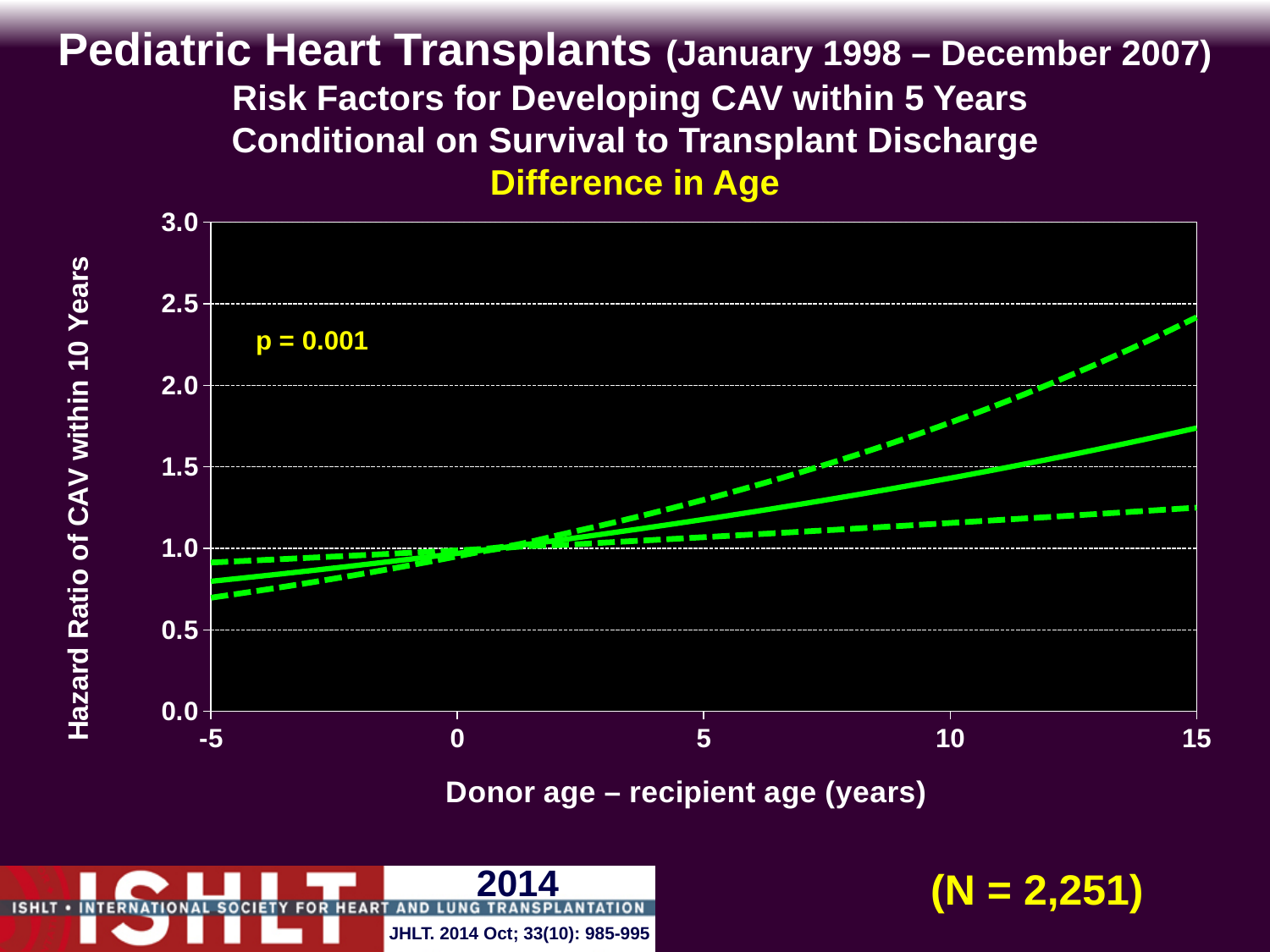
How many lines are plotted on the chart? 3 Is the value of the upper dashed line at a donor-recipient age difference of 5 years greater or less than 1.5? less Is the value of the lower dashed line at a donor-recipient age difference of 15 years greater or less than 1.5? less What is the maximum value shown on the y axis of the chart? 3.0 Is the value of the upper dashed line at a donor-recipient age difference of 15 years greater or less than 2.0? greater Does the hazard ratio rise or fall as the donor age minus recipient age increases from -5 to 15 years? rise What p-value is printed on the chart? p = 0.001 What kind of chart is shown on the slide? line chart